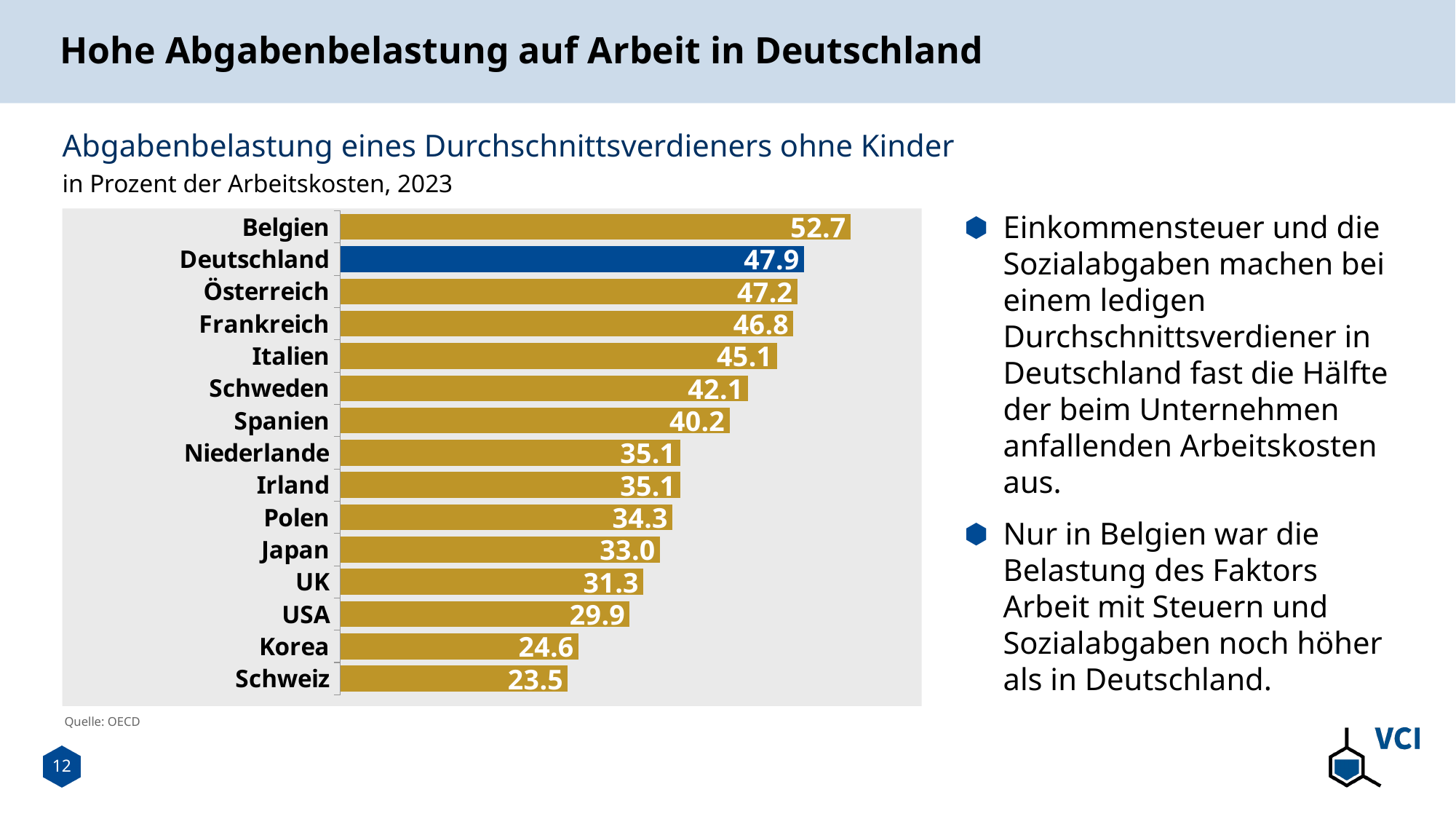
Which country has the lowest value? Schweiz What is the value for Schweden? 42.1 Which is larger, the value for Frankreich or the value for Italien? Frankreich What is the value for Japan? 33.0 What kind of chart is shown on the slide? Bar chart What is the value for Deutschland? 47.9 What is the source cited for the chart? OECD How many countries are shown in the chart? 15 Which bar is highlighted in a different colour (blue) from the others? Deutschland What is the difference between the values for Belgien and Deutschland? 4.8 What is the difference between the values for Spanien and Korea? 15.6 Which country has the highest value? Belgien